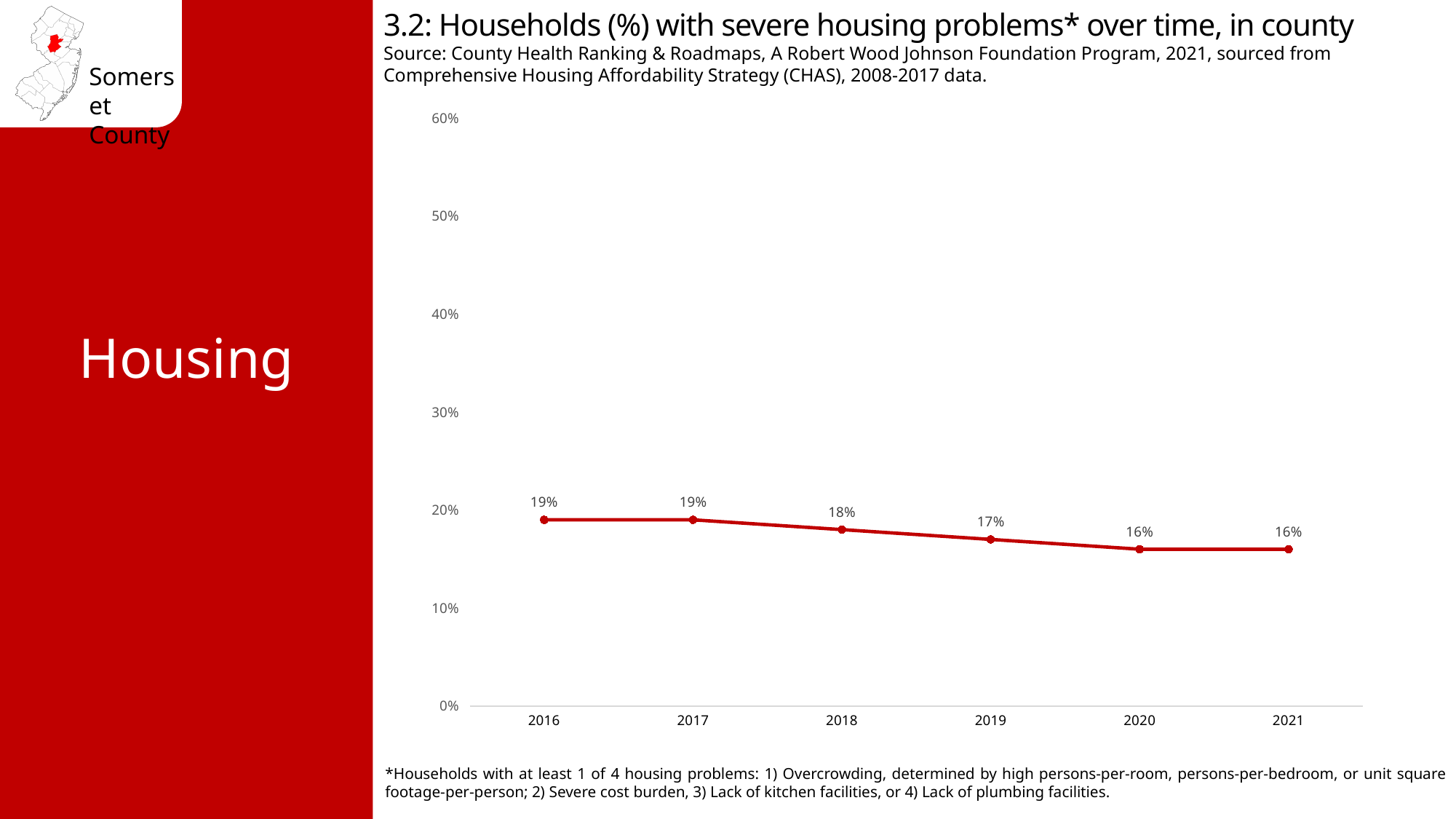
What is the difference between the 2016 value and the 2021 value? 3% What percentage of households had severe housing problems in 2016? 19% What percentage of households had severe housing problems in 2021? 16% What is the value shown for 2019? 17% What is the value shown for 2018? 18% What is the highest value shown on the y axis? 60% Which year has the larger value, 2018 or 2020? 2018 Is the value for 2017 greater or less than 20%? less Do the values rise or fall from 2016 to 2021? fall How many years are plotted on the x axis? 6 What kind of chart is shown on the slide? line chart Which year has the lowest value on the chart? 2020 and 2021